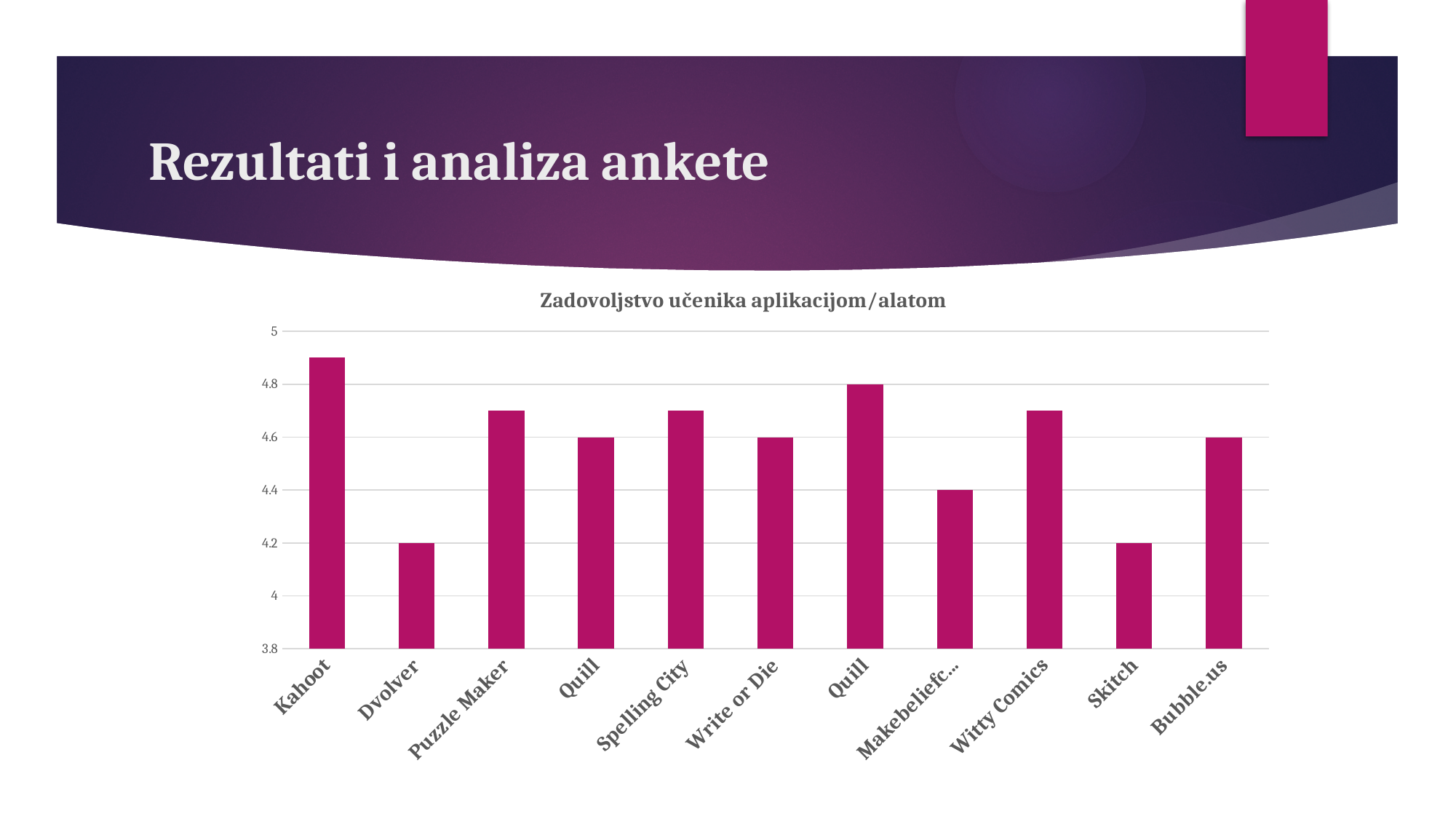
What is the value for Write or Die? 4.6 What is the value for Bubble.us? 4.6 Is the value for Kahoot greater or less than 4.8? greater What is the title of the chart? Zadovoljstvo učenika aplikacijom/alatom What kind of chart is shown on the slide? bar chart Which is larger, the value for Kahoot or the value for Dvolver? Kahoot Which category has the highest value in the chart? Kahoot What is the value for Dvolver? 4.2 What is the difference between the value for Write or Die and the value for Dvolver? 0.4 How many categories are shown on the x axis of the chart? 11 Is the value for Witty Comics greater or less than 4.8? less What is the value for Skitch? 4.2